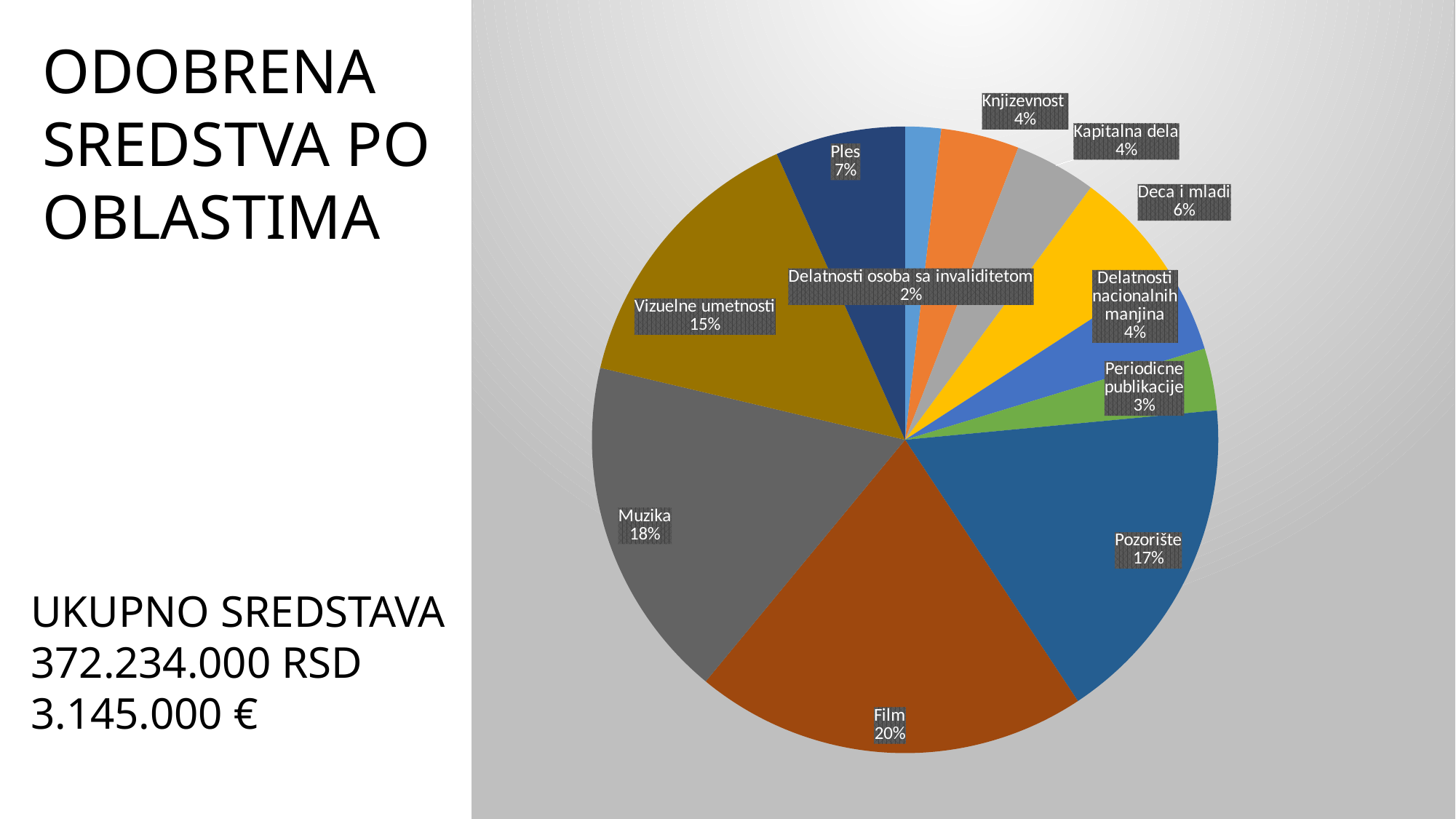
What percentage is shown for Muzika? 18% What percentage is shown for Periodicne publikacije? 3% What share of the pie does Film account for? 20% Which category has the largest slice of the pie? Film What is the difference in percentage points between Film and Pozorište? 3 What percentage is shown for Deca i mladi? 6% What type of chart is shown on the slide? pie chart Which category has the smallest slice of the pie? Delatnosti osoba sa invaliditetom Which is larger, the share for Muzika or the share for Vizuelne umetnosti? Muzika What is the title of the slide containing the pie chart? ODOBRENA SREDSTVA PO OBLASTIMA How many slices does the pie chart have? 11 What percentage is shown for Vizuelne umetnosti? 15%